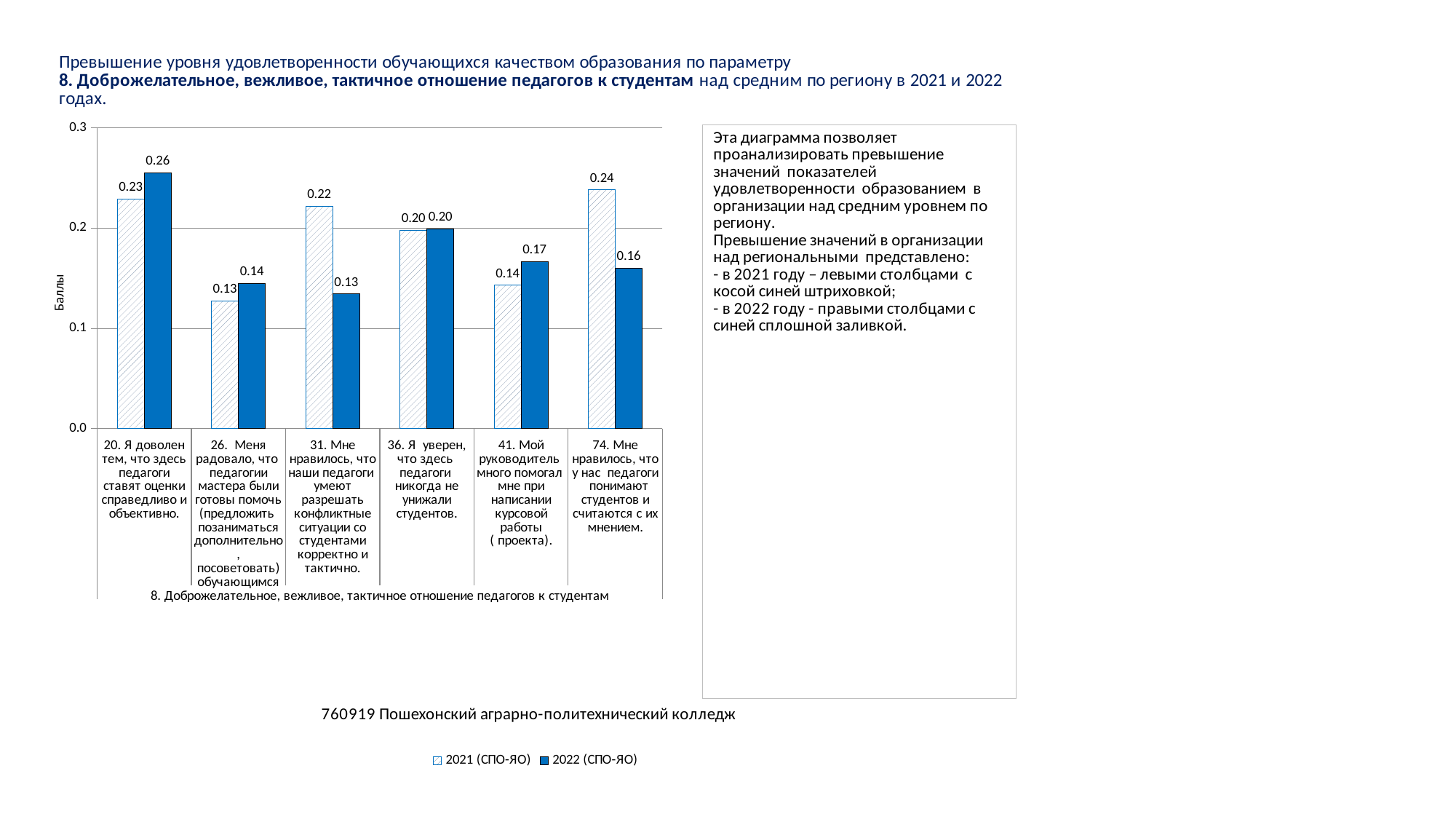
What kind of chart is shown on the slide? Bar chart For statement 41, which year has the larger value, 2021 or 2022? 2022 What is the 2022 (СПО-ЯО) value for statement 74 ("Мне нравилось, что у нас педагоги понимают студентов...")? 0.16 How many statements (categories) are shown on the x axis? 6 What is the 2022 (СПО-ЯО) value for statement 20 ("Я доволен тем, что здесь педагоги ставят оценки справедливо и объективно")? 0.26 What is the difference between the 2021 and 2022 values for statement 31? 0.09 How many series does the legend list? 2 What is the label of the vertical axis? Баллы What is the 2021 (СПО-ЯО) value for statement 31 ("Мне нравилось, что наши педагоги умеют разрешать конфликтные ситуации...")? 0.22 Which statement has the highest 2022 (СПО-ЯО) value? 20. Я доволен тем, что здесь педагоги ставят оценки справедливо и объективно. Which statement has the lowest 2021 (СПО-ЯО) value? 26. Меня радовало, что педагоги мастера были готовы помочь... For statement 74, which year has the larger value, 2021 or 2022? 2021